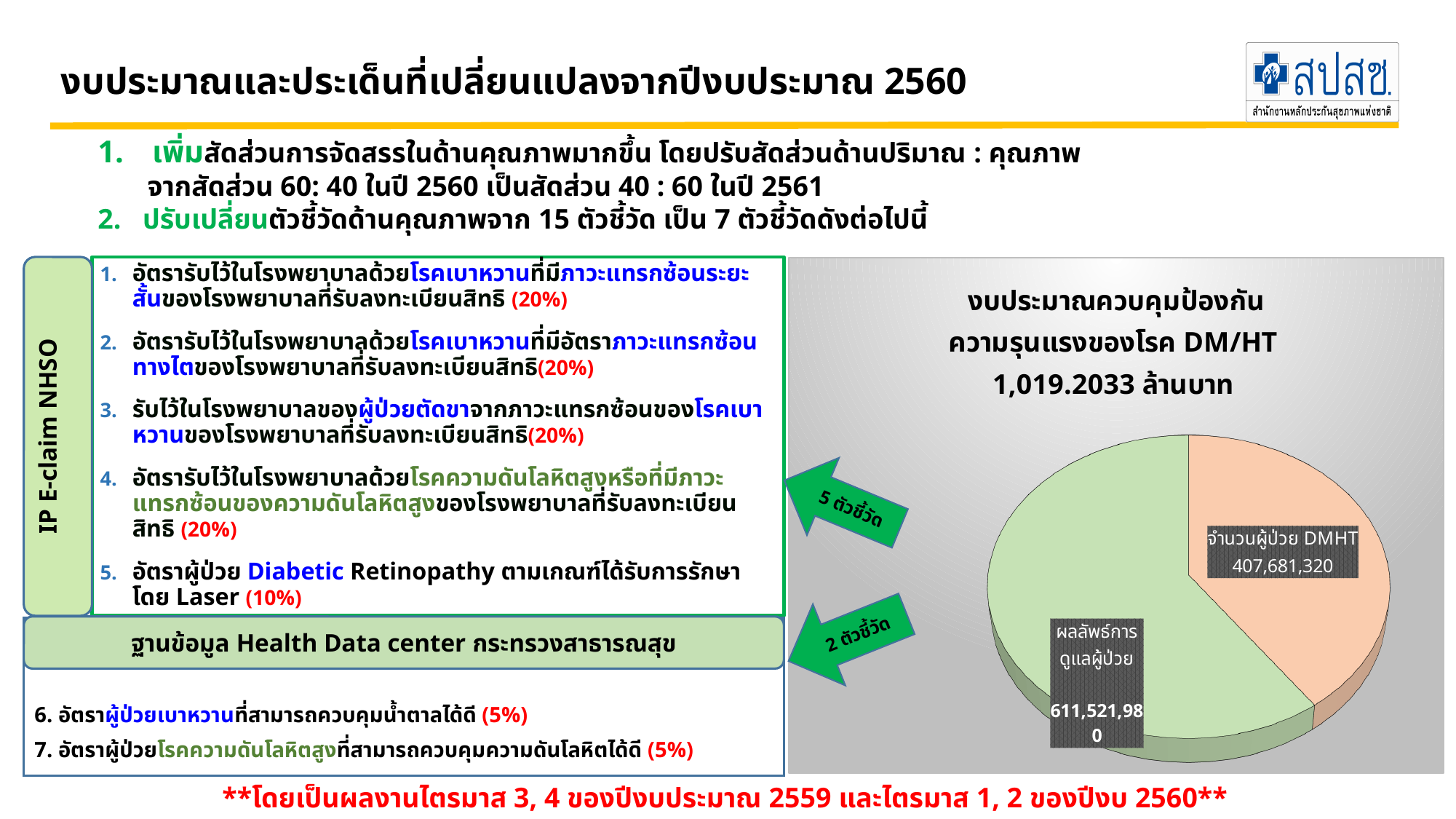
How many slices does the pie chart have? 2 What is the total of the two slices in the pie chart? 1,019,203,300 Which slice of the pie chart is the smallest? จำนวนผู้ป่วย DMHT What is the difference between the ผลลัพธ์การดูแลผู้ป่วย slice and the จำนวนผู้ป่วย DMHT slice in the pie chart? 203,840,660 Which is larger in the pie chart: จำนวนผู้ป่วย DMHT or ผลลัพธ์การดูแลผู้ป่วย? ผลลัพธ์การดูแลผู้ป่วย What kind of chart is shown on the right side of the slide? pie chart What share of the pie chart does the จำนวนผู้ป่วย DMHT slice represent? 40% Which slice of the pie chart is the largest? ผลลัพธ์การดูแลผู้ป่วย What share of the pie chart does the ผลลัพธ์การดูแลผู้ป่วย slice represent? 60% What is the value of the จำนวนผู้ป่วย DMHT slice in the pie chart? 407,681,320 What total budget amount is stated in the title of the pie chart? 1,019.2033 ล้านบาท What is the value of the ผลลัพธ์การดูแลผู้ป่วย slice in the pie chart? 611,521,980